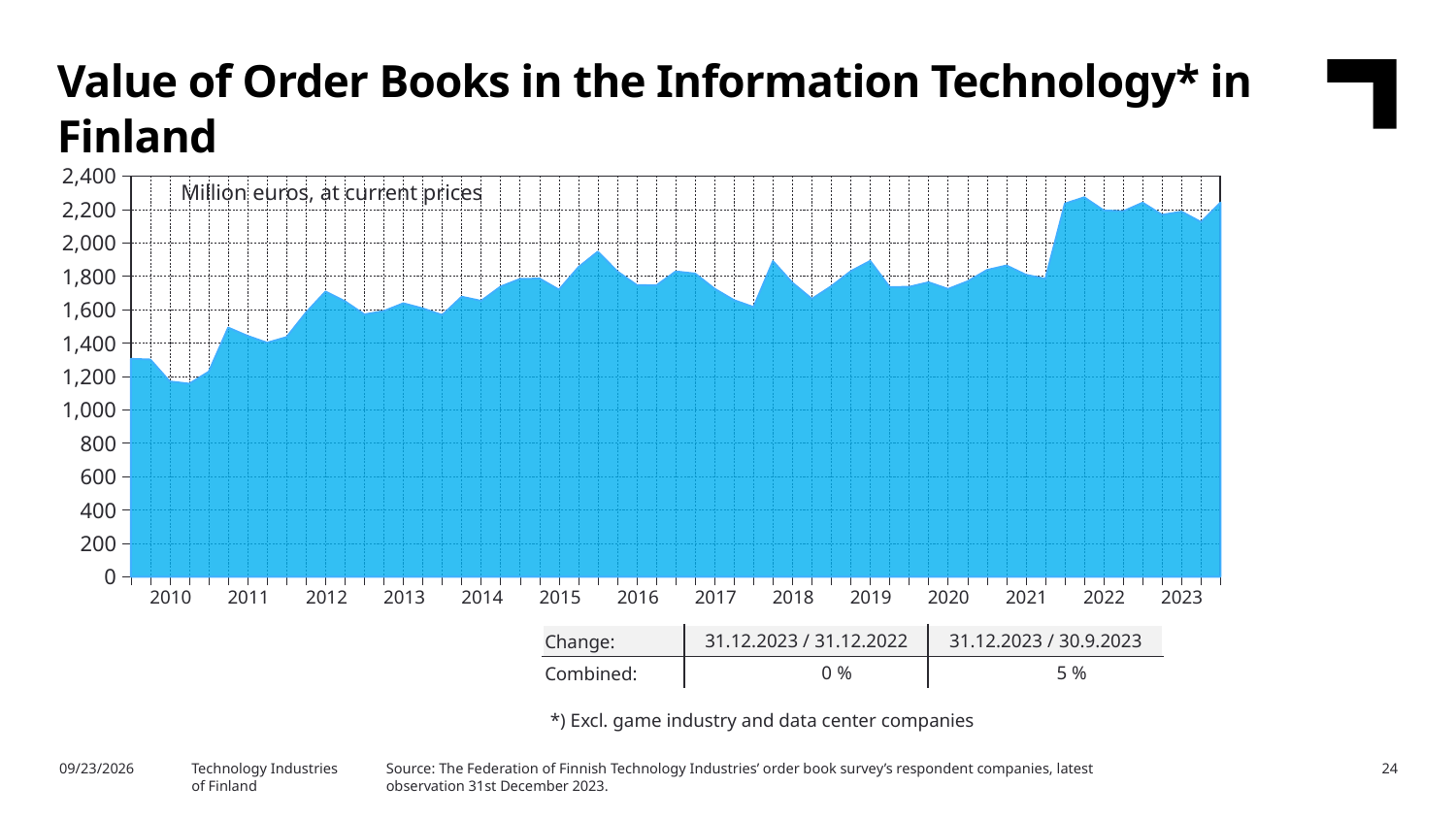
What unit is stated for the values in the chart? Million euros, at current prices Is the value in 2022 greater or less than 2,000? greater Is the value at the end of 2023 greater or less than 2,000? greater How many years are labelled on the x axis of the chart? 14 Is the peak value in 2015 greater or less than 1,800? greater What kind of chart is shown on the slide? Area chart Which year has the larger value, 2010 or 2022? 2022 In which year does the chart reach its lowest value? 2010 Overall, do the values rise or fall from 2010 to 2023? rise What is the title of the chart on the slide? Value of Order Books in the Information Technology* in Finland According to the table below the chart, what is the combined change for 31.12.2023 / 30.9.2023? 5 %